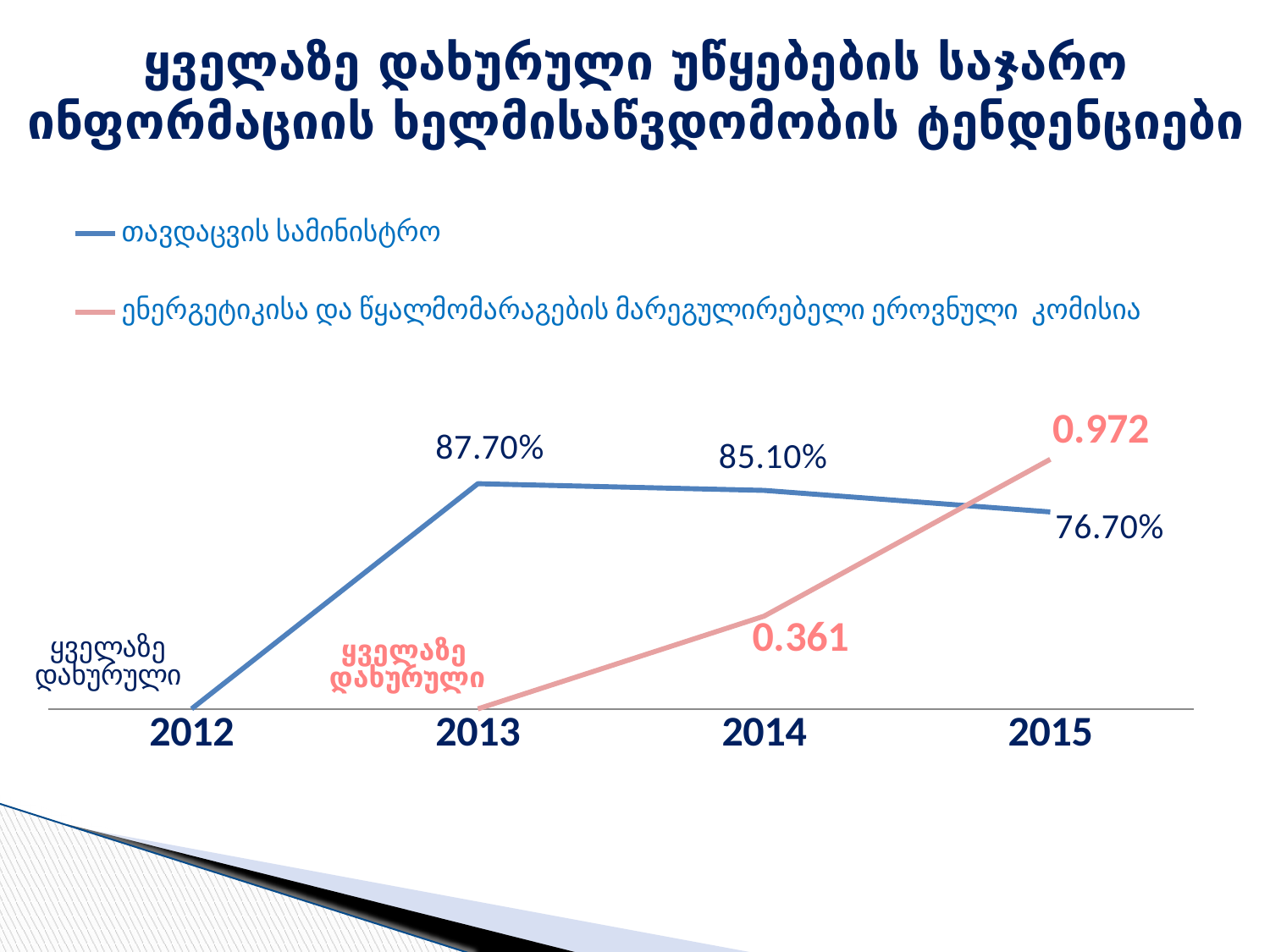
Does the თავდაცვის სამინისტრო line rise or fall from 2013 to 2015? fall What is the value for თავდაცვის სამინისტრო in 2014? 85.10% What label is shown at the 2012 point of the თავდაცვის სამინისტრო line? ყველაზე დახურული How many series does the legend list? 2 What is the difference between the თავდაცვის სამინისტრო values for 2013 and 2015? 11.00% What is the value for ენერგეტიკისა და წყალმომარაგების მარეგულირებელი ეროვნული კომისია in 2014? 0.361 In which year is the value for თავდაცვის სამინისტრო highest? 2013 What type of chart is shown on the slide? line chart How many years are shown on the x axis? 4 What is the value for ენერგეტიკისა და წყალმომარაგების მარეგულირებელი ეროვნული კომისია in 2015? 0.972 What is the value for თავდაცვის სამინისტრო in 2013? 87.70% What is the value for თავდაცვის სამინისტრო in 2015? 76.70%